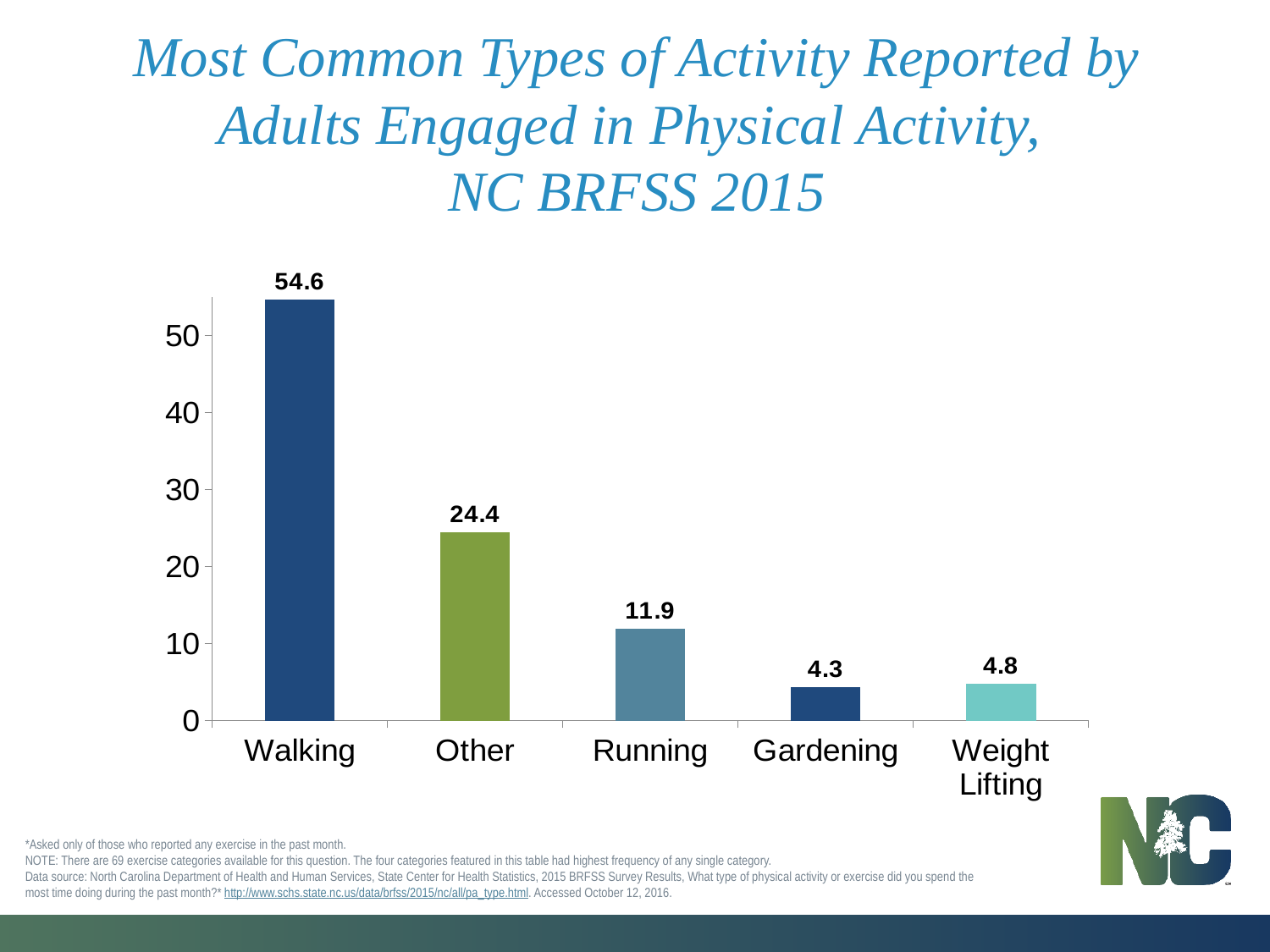
What year of NC BRFSS data does the chart title refer to? 2015 Which category has the highest value? Walking Which is larger, the value for Other or the value for Running? Other What is the difference between the values for Running and Gardening? 7.6 What is the value for Walking? 54.6 Is the value for Other greater or less than 20? greater Which category has the lowest value? Gardening What kind of chart is shown on the slide? bar chart What is the value for Weight Lifting? 4.8 How many categories are shown on the x axis? 5 What is the value for Running? 11.9 What is the difference between the values for Walking and Other? 30.2